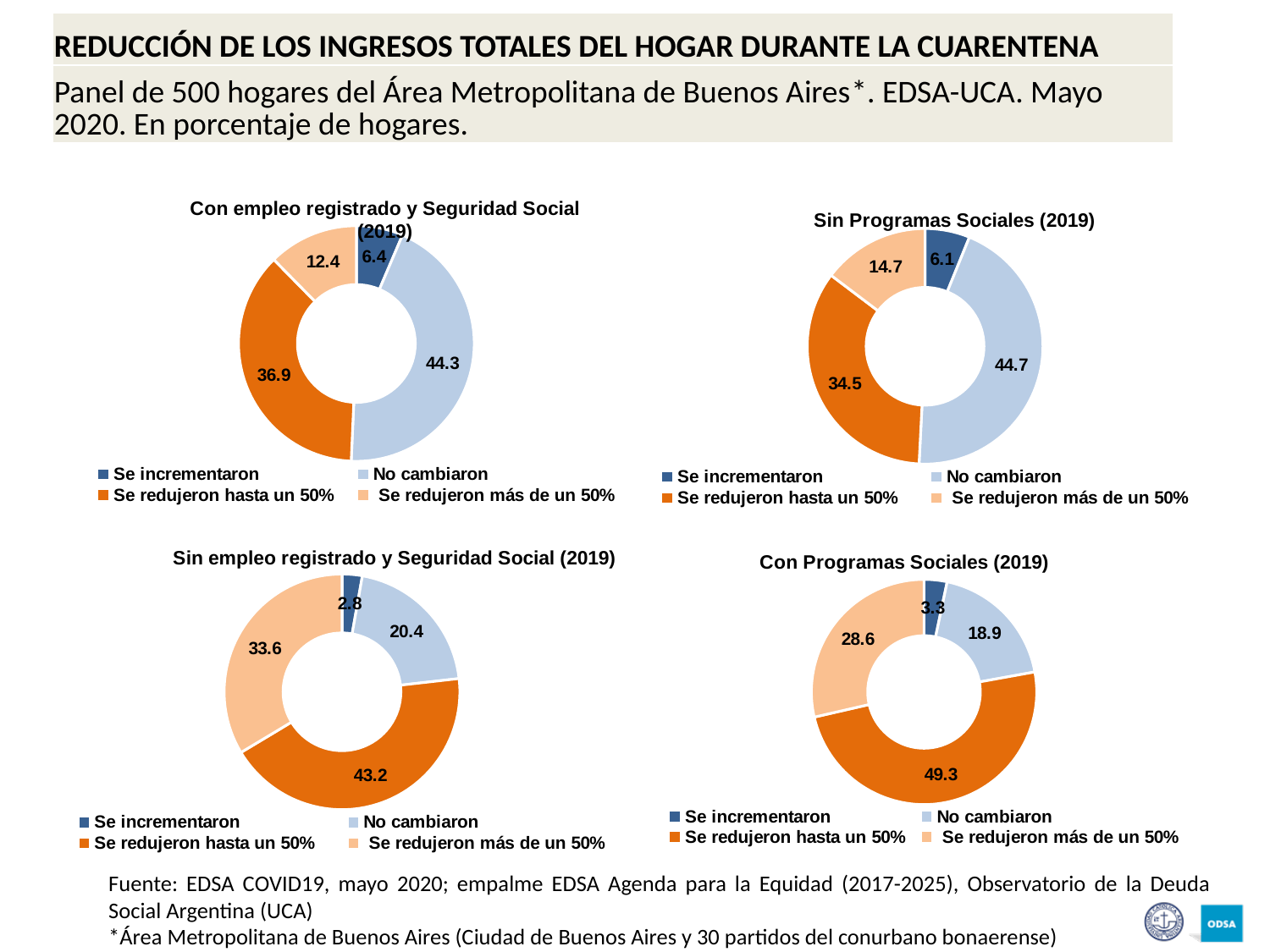
In the 'Sin Programas Sociales (2019)' chart, which category has the smallest share? Se incrementaron In the 'Sin Programas Sociales (2019)' chart, what is the value for 'Se redujeron hasta un 50%'? 34.5 In the 'Con Programas Sociales (2019)' chart, what is the value for 'Se redujeron más de un 50%'? 28.6 How many charts are on the slide? 4 In the 'Con Programas Sociales (2019)' chart, which category has the largest share? Se redujeron hasta un 50% In the 'Sin empleo registrado y Seguridad Social (2019)' chart, what is the value for 'Se incrementaron'? 2.8 In the 'Con empleo registrado y Seguridad Social (2019)' chart, which is larger: 'No cambiaron' or 'Se redujeron hasta un 50%'? No cambiaron In the 'Sin empleo registrado y Seguridad Social (2019)' chart, what is the value for 'No cambiaron'? 20.4 What kind of chart is the 'Sin Programas Sociales (2019)' chart? doughnut chart How many categories does the 'Con Programas Sociales (2019)' chart show? 4 In the 'Con empleo registrado y Seguridad Social (2019)' chart, what is the value for 'No cambiaron'? 44.3 In the 'Sin empleo registrado y Seguridad Social (2019)' chart, what is the difference between 'Se redujeron hasta un 50%' and 'Se redujeron más de un 50%'? 9.6